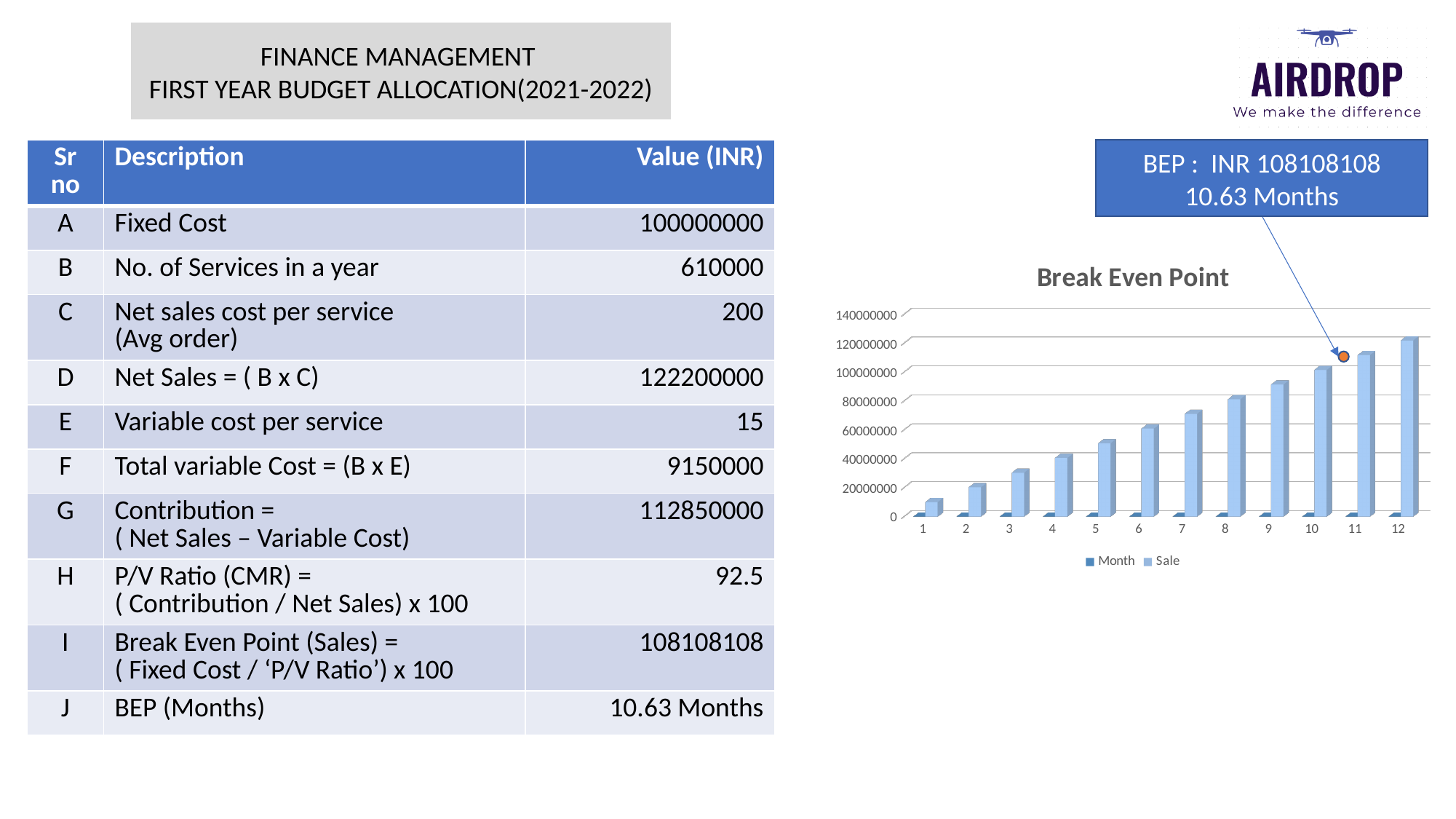
What is the title of the chart on the slide? Break Even Point How many categories are shown on the x axis of the Break Even Point chart? 12 How many series does the legend of the Break Even Point chart list? 2 In the Break Even Point chart, is the value for month 12 greater or less than 100000000? greater What are the two entries in the legend of the Break Even Point chart? Month and Sale In the Break Even Point chart, is the value for month 6 greater or less than 40000000? greater In the Break Even Point chart, do the bar values rise or fall from month 1 to month 12? rise What kind of chart is the Break Even Point chart? bar chart In the Break Even Point chart, which month has the lowest bar? 1 In the Break Even Point chart, which month has the highest bar? 12 In the Break Even Point chart, is the value for month 1 greater or less than 20000000? less In the Break Even Point chart, which is larger, the value for month 10 or the value for month 5? month 10